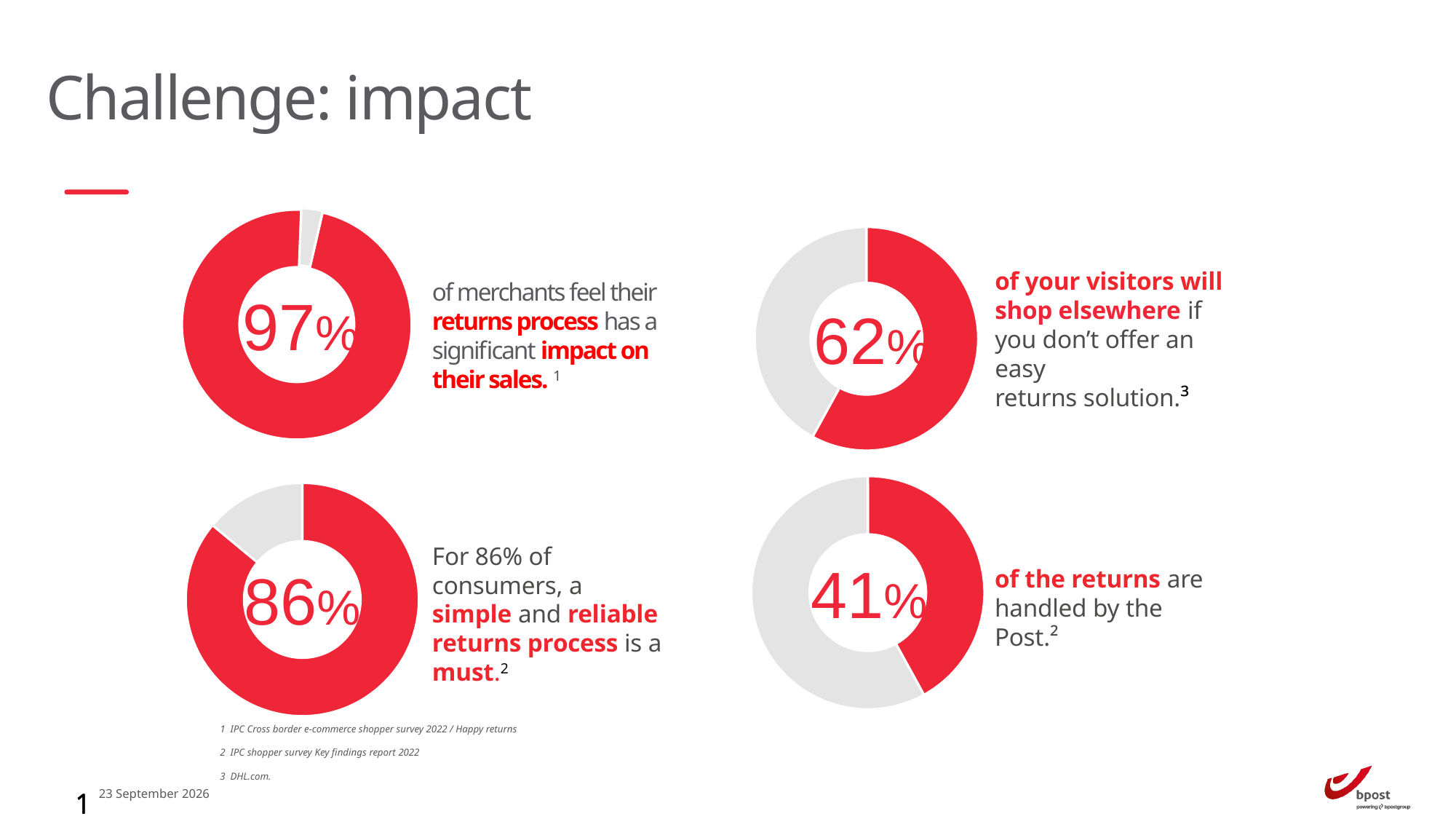
What percentage is shown in the centre of the bottom-right donut chart? 41% What colour is used for the highlighted (filled) portion of each donut chart? Red What kind of chart is used to display the percentages on this slide? Donut (pie) chart Which is larger: the percentage in the top-right donut chart or the percentage in the bottom-left donut chart? The bottom-left chart (86%) What is the difference between the percentage in the top-left donut chart and the percentage in the bottom-right donut chart? 56 percentage points Which of the four donut charts on the slide shows the lowest percentage? The bottom-right chart (41%) What percentage is shown in the centre of the bottom-left donut chart? 86% How many donut charts are shown on the slide? 4 Which of the four donut charts on the slide shows the highest percentage? The top-left chart (97%) What percentage is shown in the centre of the top-right donut chart? 62% What percentage is shown in the centre of the top-left donut chart? 97%